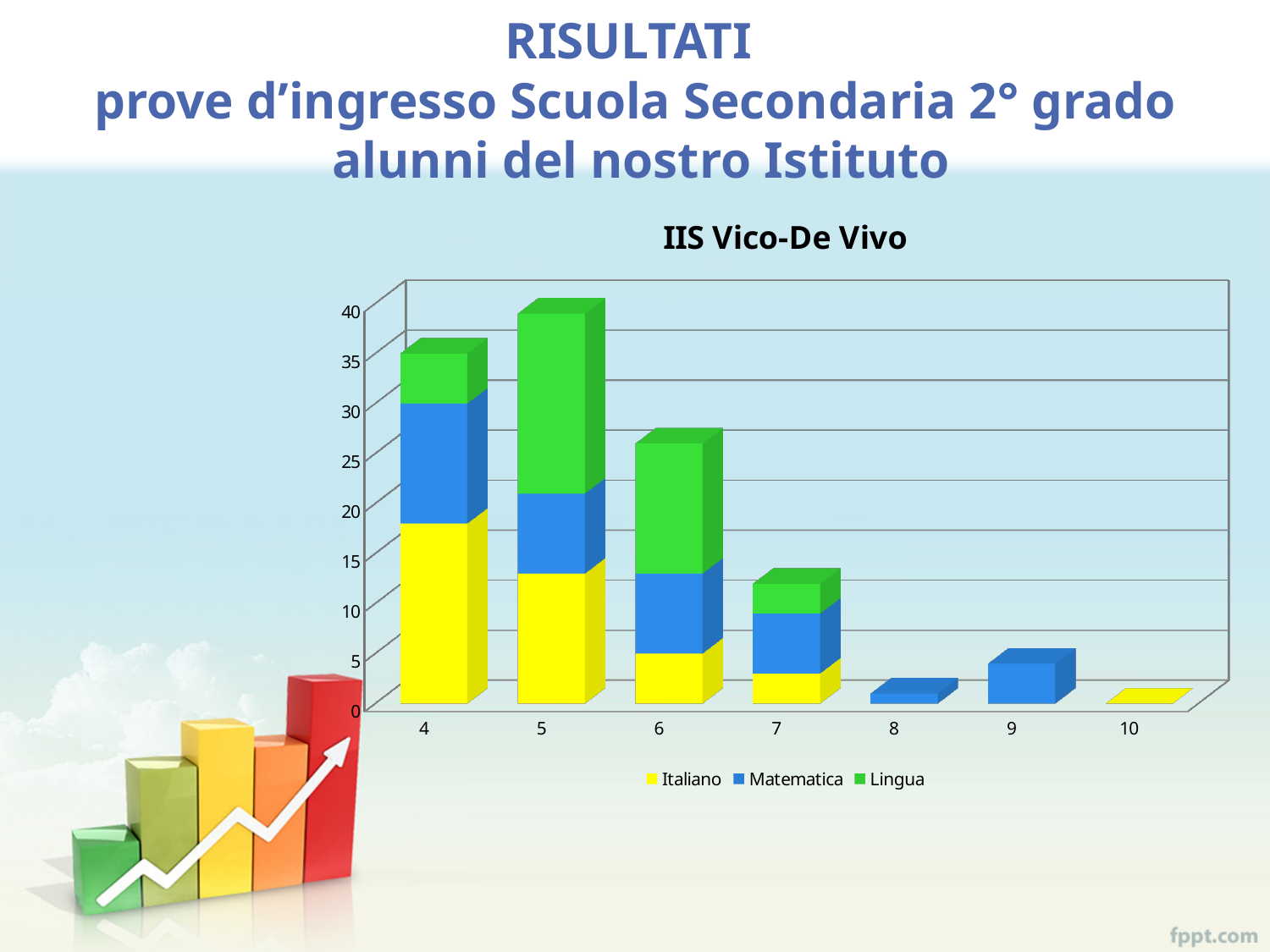
What kind of chart is shown on the slide? Stacked bar chart How many series does the legend list? 3 Is the total stacked value for category 7 greater or less than 15? less Is the total stacked value for category 4 greater or less than 30? greater Which colour represents the Lingua series in the legend? Green How many categories are shown on the x axis? 7 Is the total stacked value for category 6 greater or less than 30? less Which has the larger total stacked bar, category 4 or category 6? 4 Which category has the highest total stacked bar? 5 What is the title of the chart? IIS Vico-De Vivo